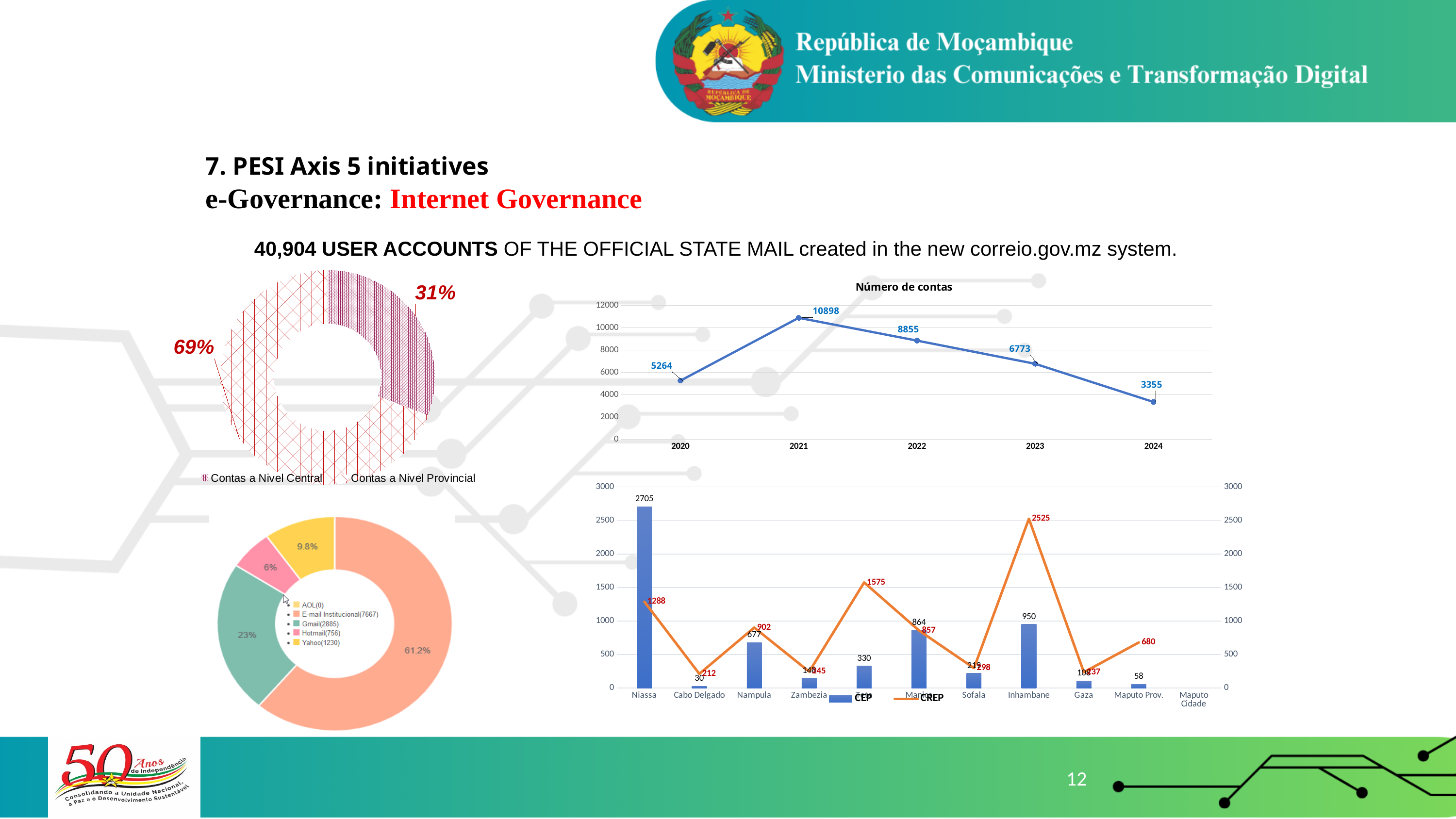
In the bottom-right chart with CEP and CREP, what is the CEP value for Niassa? 2705 In the 'Número de contas' line chart, how many years are plotted? 5 In the top-left donut chart, what share is 'Contas a Nivel Provincial'? 69% In the bottom-right chart with CEP and CREP, how many series does the legend list? 2 In the 'Número de contas' line chart, what is the value for 2021? 10898 In the bottom-left donut chart of e-mail providers, what share does the largest slice (E-mail Institucional) have? 61.2% In the bottom-right chart with CEP and CREP, what is the CREP value for Inhambane? 2525 In the 'Número de contas' line chart, what is the difference between the 2021 and 2024 values? 7543 In the 'Número de contas' line chart, which year has the lowest value? 2024 In the 'Número de contas' line chart, do the values rise or fall from 2021 to 2024? fall In the bottom-right chart with CEP and CREP, which province has the highest CEP bar? Niassa In the bottom-right chart with CEP and CREP, which is larger for Tete: the CEP value or the CREP value? CREP